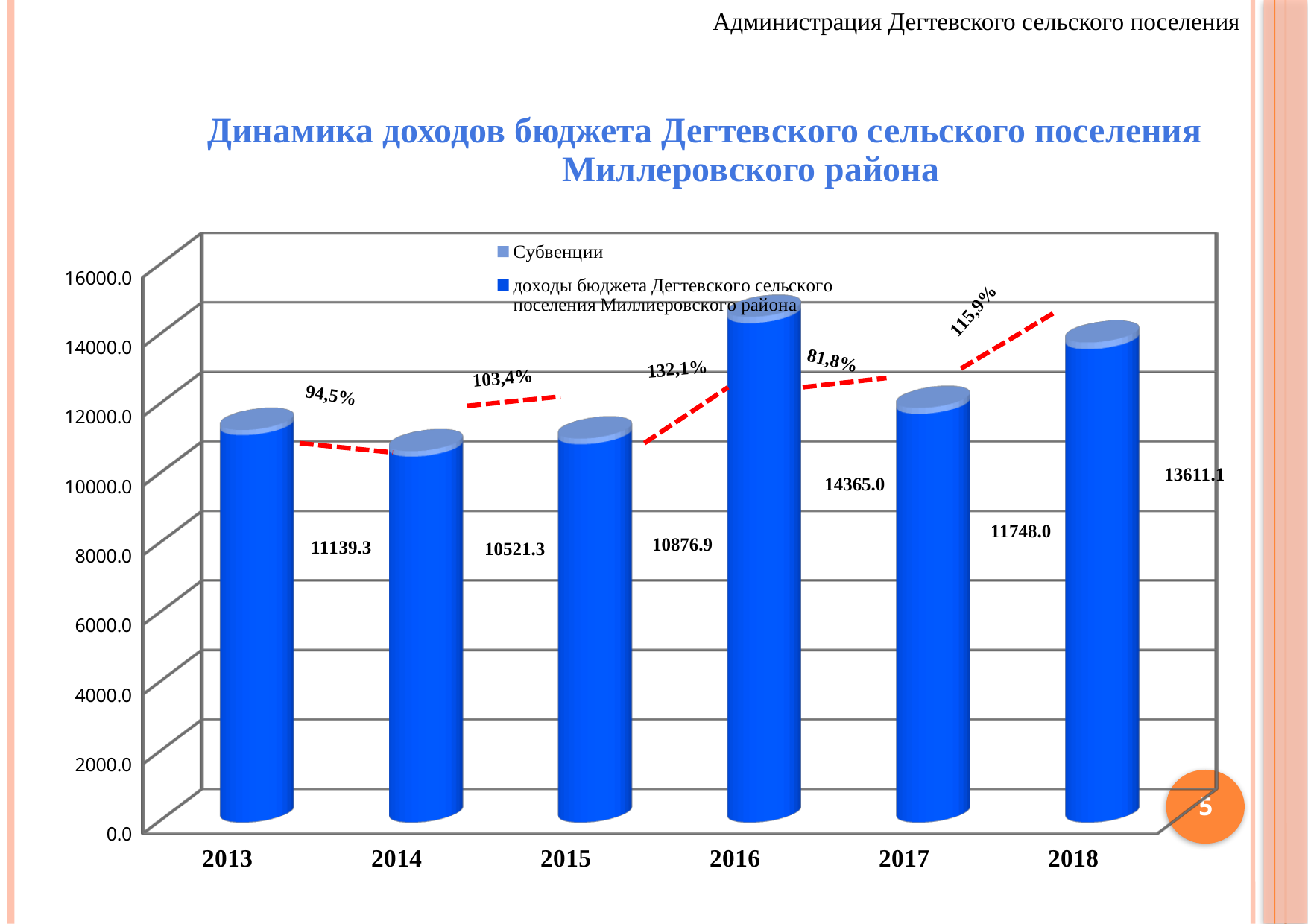
How many series does the legend list? 2 What kind of chart is shown on the slide? bar chart What is the value of the bar for 2016? 14365.0 Which year has the lowest bar? 2014 What percentage label is shown between the 2015 and 2016 bars? 132,1% Which is larger, the value for 2015 or the value for 2017? 2017 What is the difference between the values for 2016 and 2017? 2617.0 What is the value of the bar for 2018? 13611.1 What is the value of the bar for 2013? 11139.3 Which year has the highest bar? 2016 Is the value for 2018 greater or less than 12000.0? greater How many years are shown on the x axis? 6